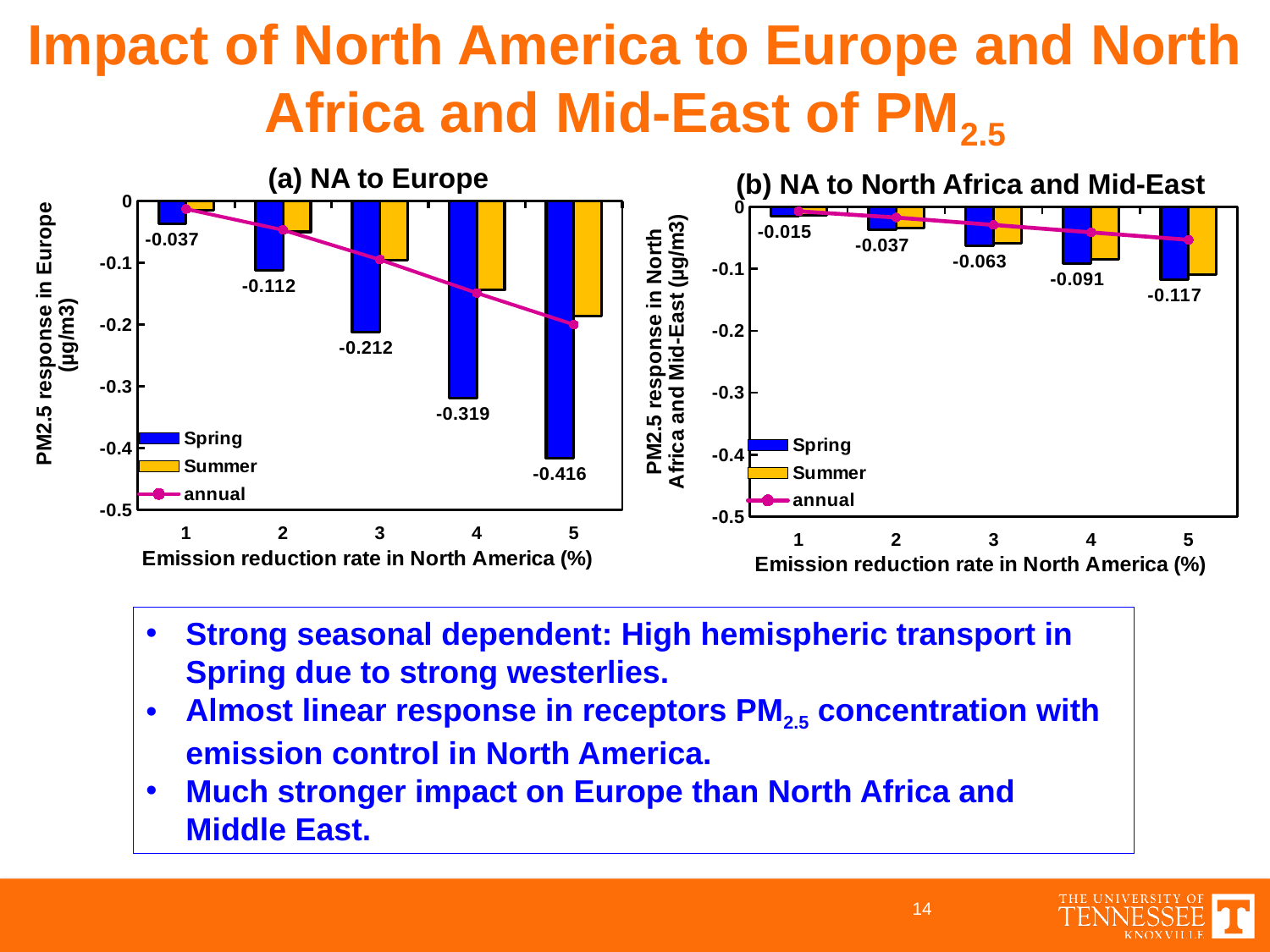
In chart (a) NA to Europe, which season shows the more negative PM2.5 response at a 5% emission reduction rate, Spring or Summer? Spring In chart (a) NA to Europe, at which emission reduction rate is the labelled Spring response most negative? 5 In chart (b) NA to North Africa and Mid-East, by how much does the labelled Spring value at 5% differ in magnitude from the value at 1%? 0.102 In chart (a) NA to Europe, what is the labelled Spring value at a 5% emission reduction rate? -0.416 How many series does the legend list in chart (b) NA to North Africa and Mid-East? 3 In chart (a) NA to Europe, do the Spring values rise or fall as the emission reduction rate increases? fall How many emission reduction rate categories are shown on the x axis of chart (a) NA to Europe? 5 In chart (b) NA to North Africa and Mid-East, what is the labelled Spring value at a 1% emission reduction rate? -0.015 In chart (b) NA to North Africa and Mid-East, what is the labelled Spring value at a 4% emission reduction rate? -0.091 In chart (a) NA to Europe, what is the labelled Spring PM2.5 response at a 3% emission reduction rate? -0.212 In chart (a) NA to Europe, by how much does the labelled Spring value at 5% differ in magnitude from the value at 1%? 0.379 In chart (a) NA to Europe, is the Summer value at a 4% emission reduction rate greater or less than -0.1? less